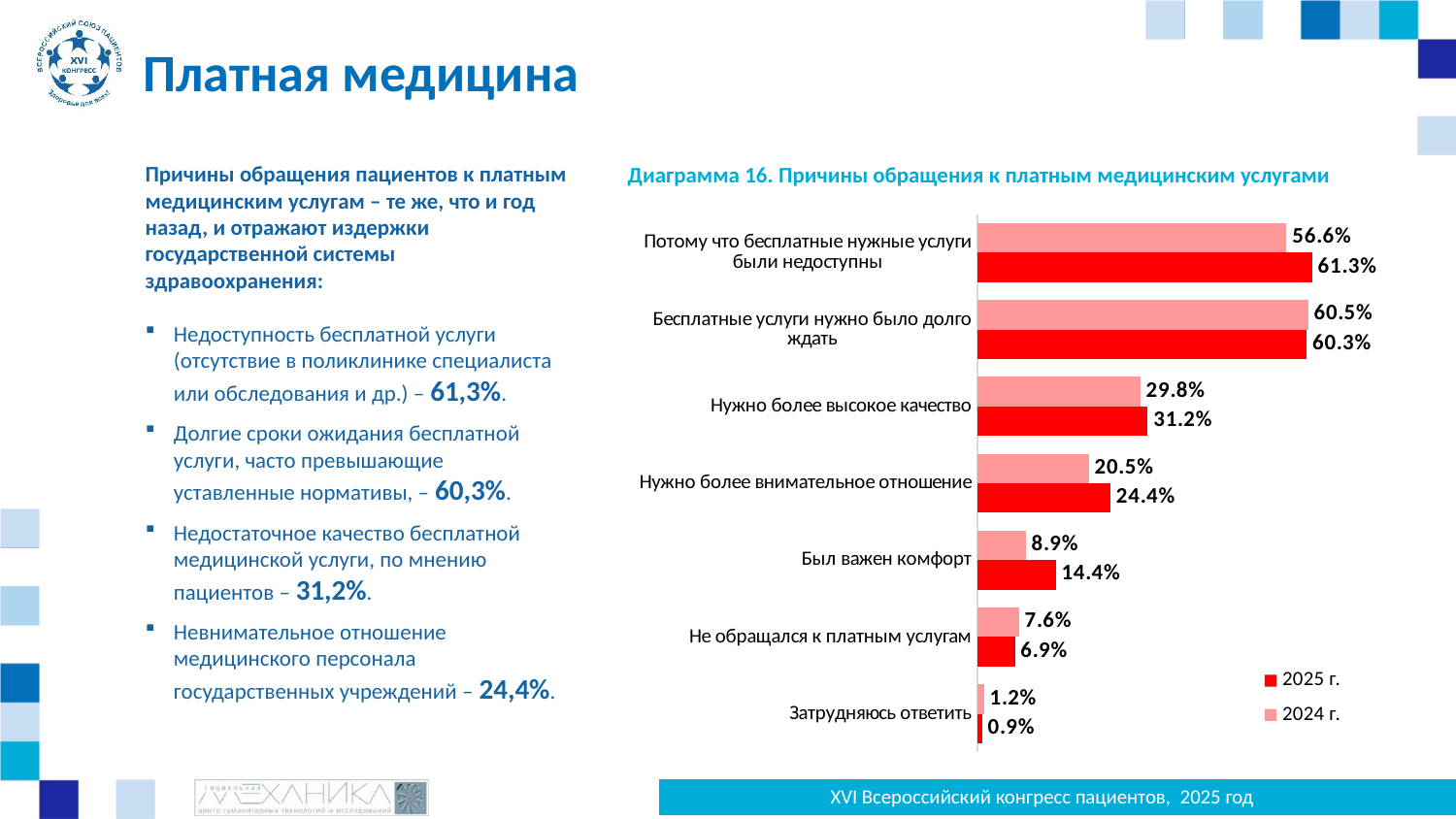
Which category has the highest 2024 г. value? Бесплатные услуги нужно было долго ждать What is the difference between the 2025 г. and 2024 г. values for «Был важен комфорт»? 5.5% Which category has the lowest 2025 г. value? Затрудняюсь ответить What is the 2025 г. value for «Нужно более внимательное отношение»? 24.4% For «Не обращался к платным услугам», which year has the larger value, 2024 г. or 2025 г.? 2024 г. What type of chart is shown on the slide? Bar chart What is the 2024 г. value for «Был важен комфорт»? 8.9% How many categories are shown in the chart? 7 What is the title of the chart? Диаграмма 16. Причины обращения к платным медицинским услугам Which colour represents the 2025 г. series in the legend? Red What is the 2025 г. value for «Потому что бесплатные нужные услуги были недоступны»? 61.3% How many series does the legend list? 2